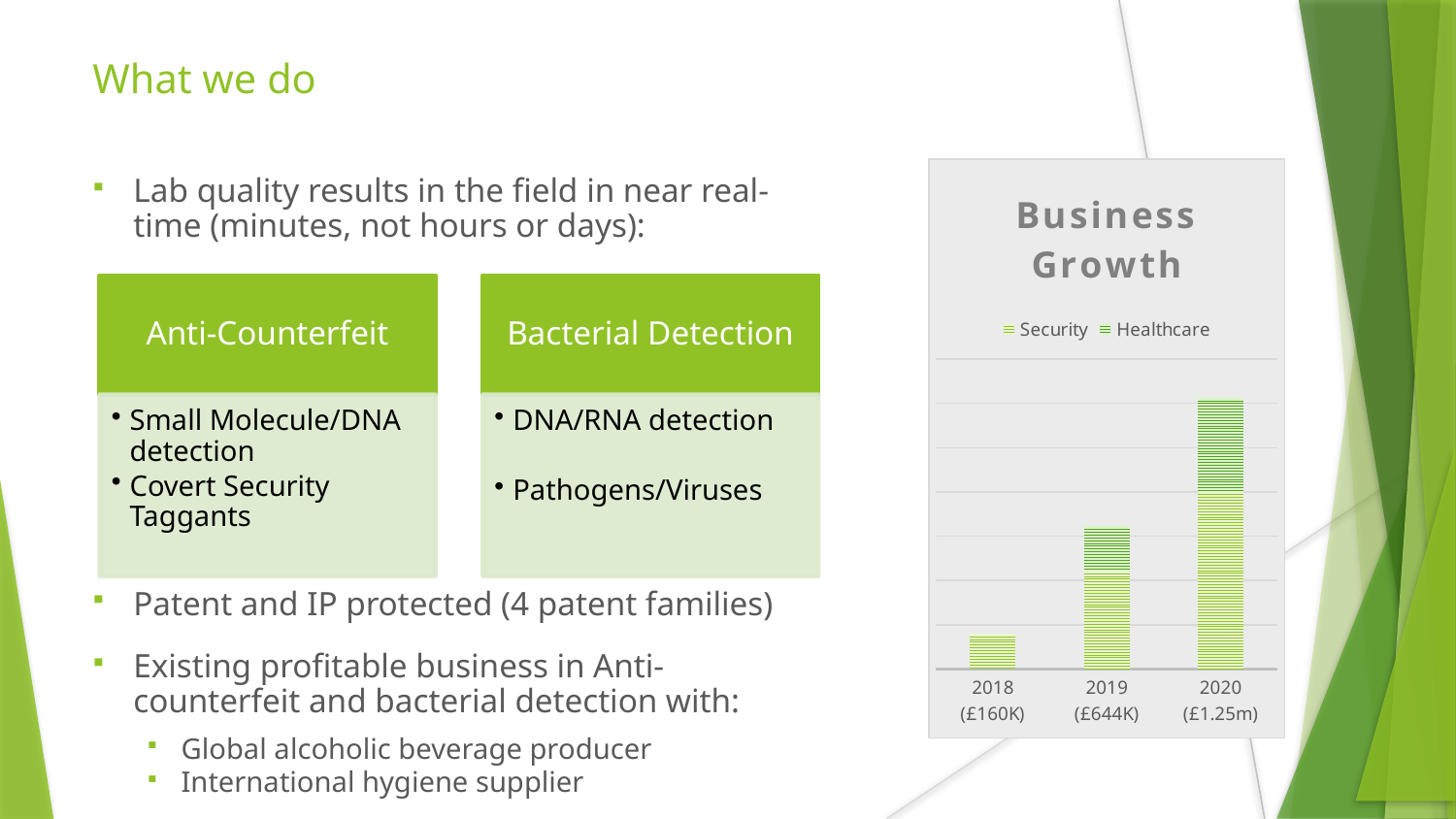
Which year has the tallest bar in the Business Growth chart? 2020 Which year has the shortest bar in the Business Growth chart? 2018 How many series does the chart's legend list? 2 How many years are shown on the x axis of the chart? 3 What value is printed under the 2019 label in the chart? £644K What kind of chart is shown on the slide? bar chart What value is printed under the 2020 label in the chart? £1.25m What is the title of the chart? Business Growth Do the bars in the Business Growth chart rise or fall from 2018 to 2020? rise Which is larger, the value for 2019 or the value for 2018? 2019 What value is printed under the 2018 label in the chart? £160K What are the two series named in the chart's legend? Security and Healthcare